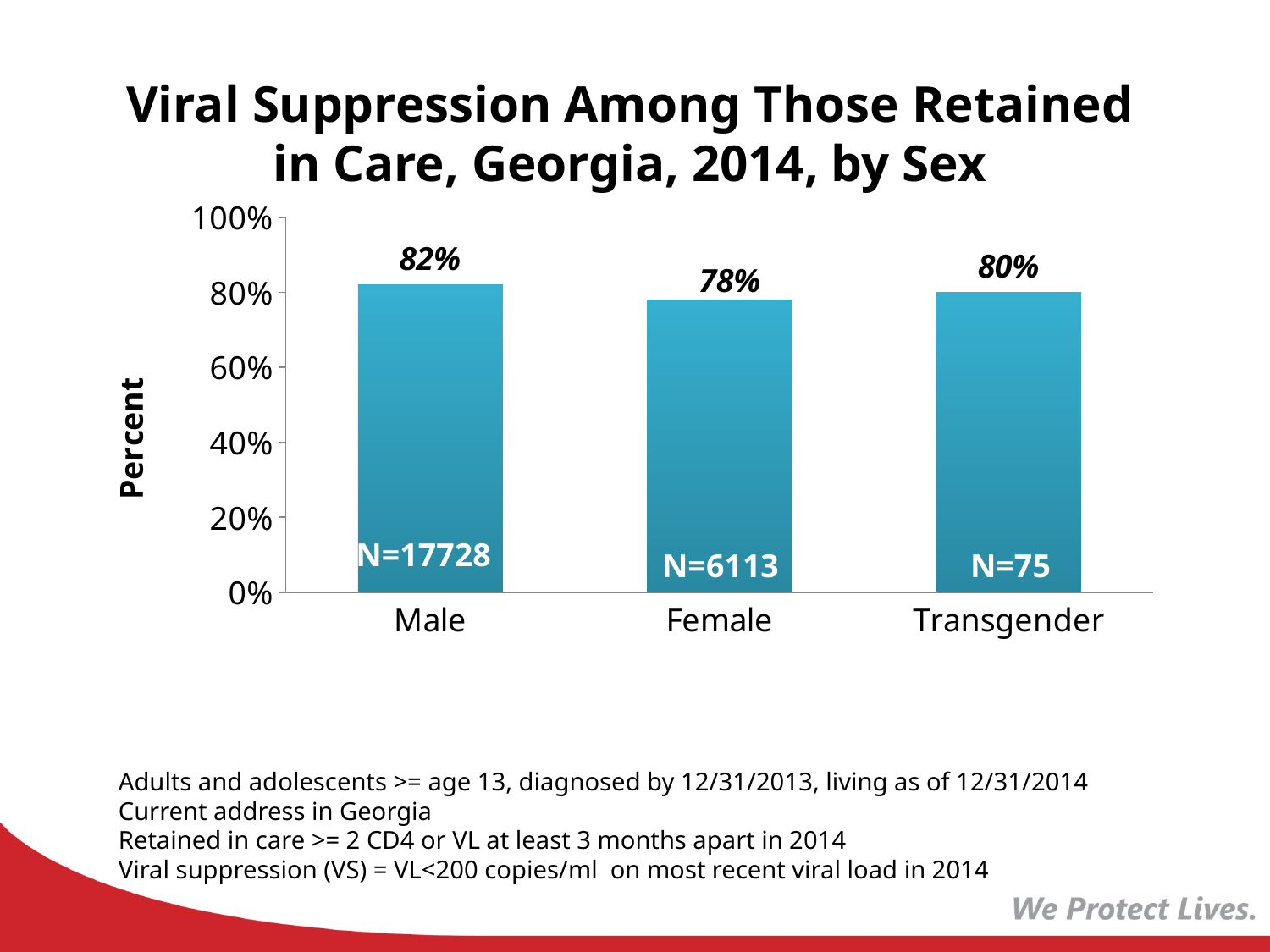
How many categories are shown on the x axis? 3 What is the label on the y axis? Percent What is the N value shown for the Female bar? N=6113 What is the viral suppression percentage for Transgender? 80% What is the viral suppression percentage for Female? 78% Is the value for Female greater or less than 80%? less Which category has the highest viral suppression percentage? Male Which has a higher viral suppression percentage, Transgender or Female? Transgender What kind of chart is shown on the slide? Bar chart Which category has the lowest viral suppression percentage? Female What is the viral suppression percentage for Male? 82% What is the difference in percentage points between Male and Female viral suppression? 4